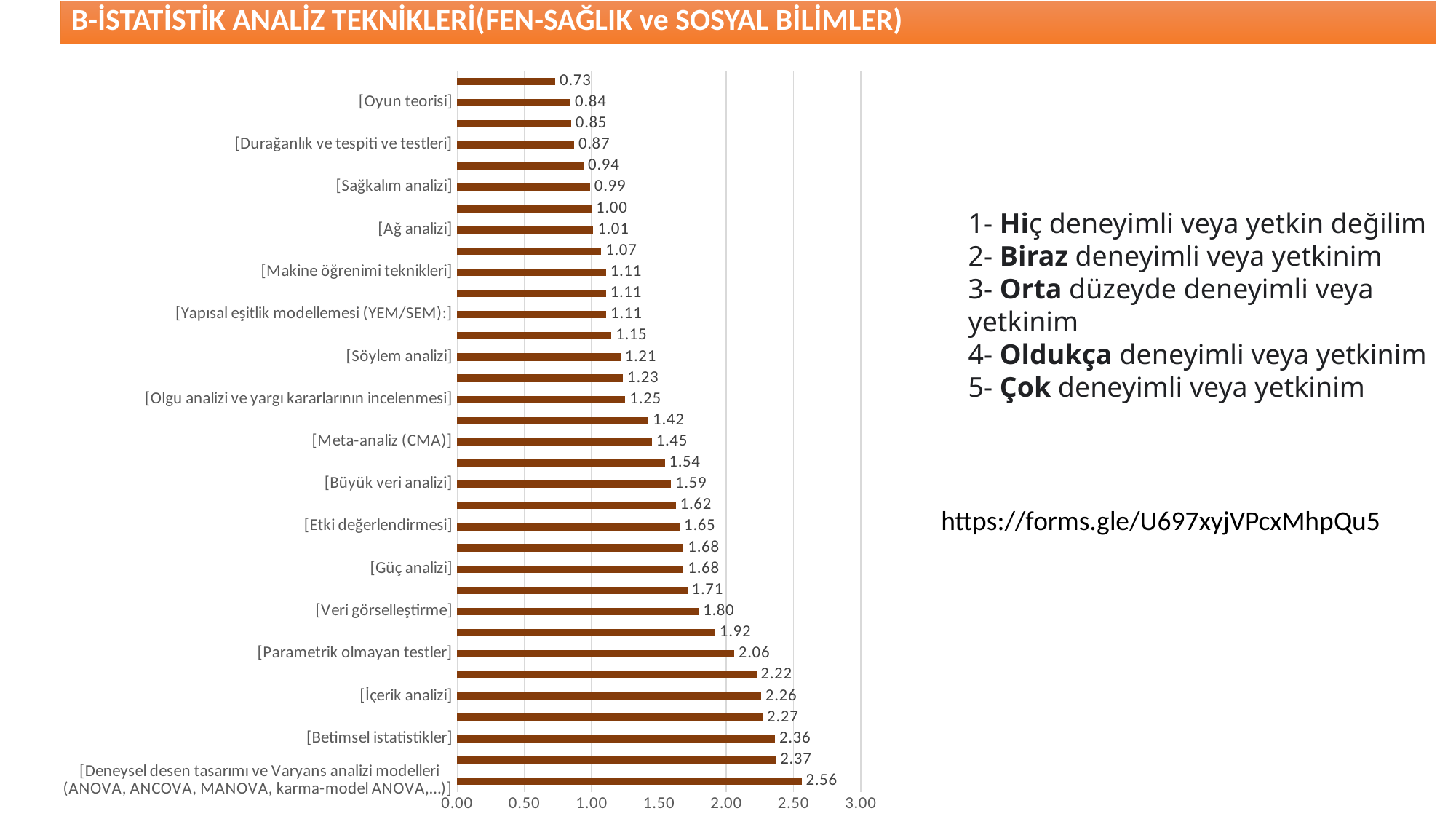
What is the highest value shown in the chart? 2.56 What is the title shown at the top of the slide? B-İSTATİSTİK ANALİZ TEKNİKLERİ(FEN-SAĞLIK ve SOSYAL BİLİMLER) Which has a larger value, Güç analizi or Büyük veri analizi? Güç analizi Is the value for Veri görselleştirme greater or less than 1.50? greater What is the value for Parametrik olmayan testler? 2.06 What is the value for Betimsel istatistikler? 2.36 What is the value for Meta-analiz (CMA)? 1.45 What is the lowest value shown in the chart? 0.73 What type of chart is shown on the slide? bar chart What is the value for Oyun teorisi? 0.84 Which category has the highest value? Deneysel desen tasarımı ve Varyans analizi modelleri (ANOVA, ANCOVA, MANOVA, karma-model ANOVA,...) What is the difference between the values for Betimsel istatistikler and Oyun teorisi? 1.52